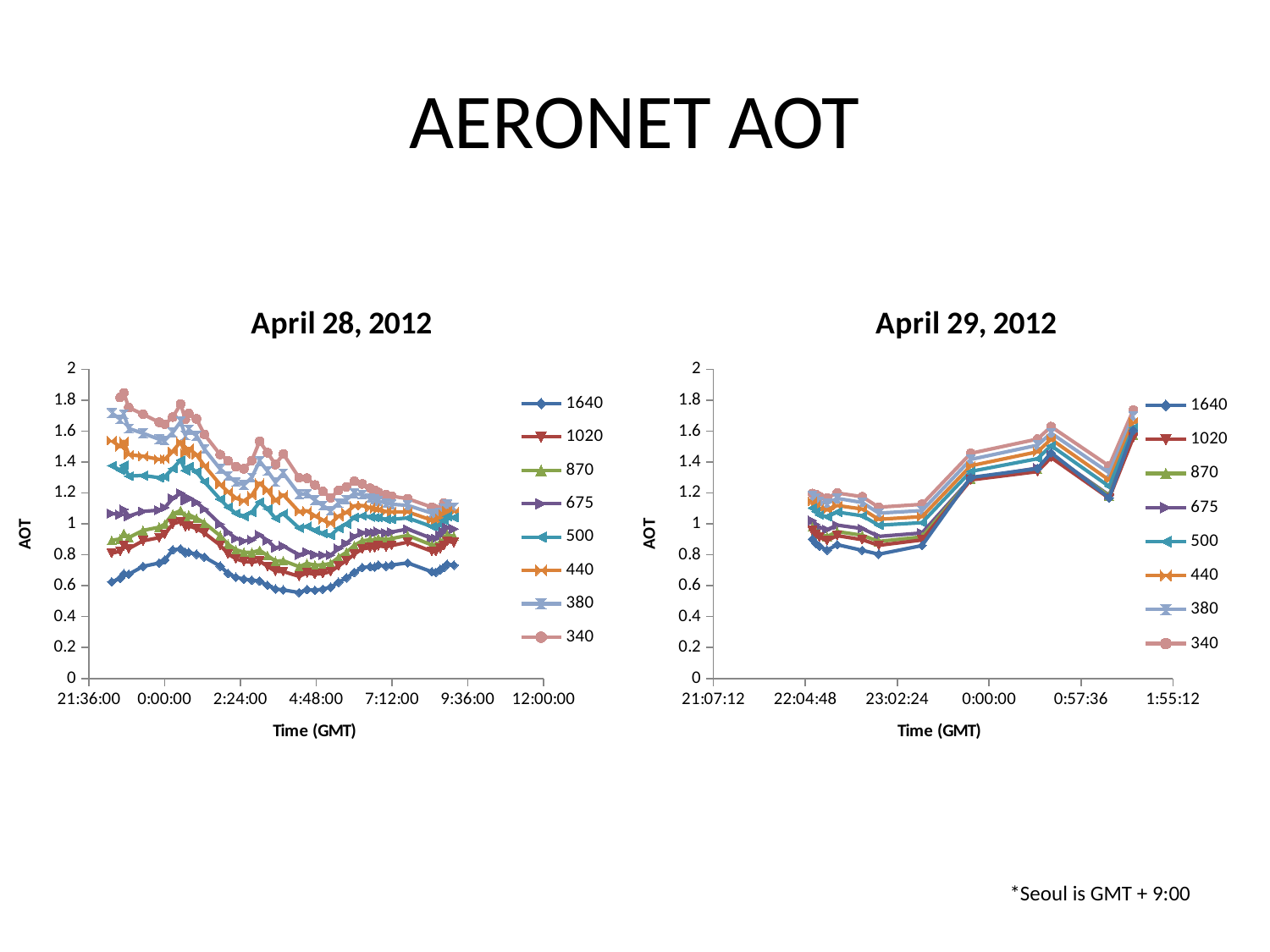
In the April 28, 2012 chart, which series has the highest AOT values throughout? 340 In the April 28, 2012 chart, which series has higher values, 1640 or 340? 340 In the April 28, 2012 chart, is the first value of the 340 series greater or less than 1.6? greater What is the x-axis title of the April 29, 2012 chart? Time (GMT) What kind of chart is the April 28, 2012 chart? line chart In the April 29, 2012 chart, is the value of the 1640 series at 23:02:24 greater or less than 1? less In the April 29, 2012 chart, do the AOT values generally rise or fall from the start to the end of the period? rise What is the y-axis title of the April 28, 2012 chart? AOT How many series does the legend of the April 28, 2012 chart list? 8 In the April 28, 2012 chart, does the 340 series generally rise or fall over time? fall How many series does the legend of the April 29, 2012 chart list? 8